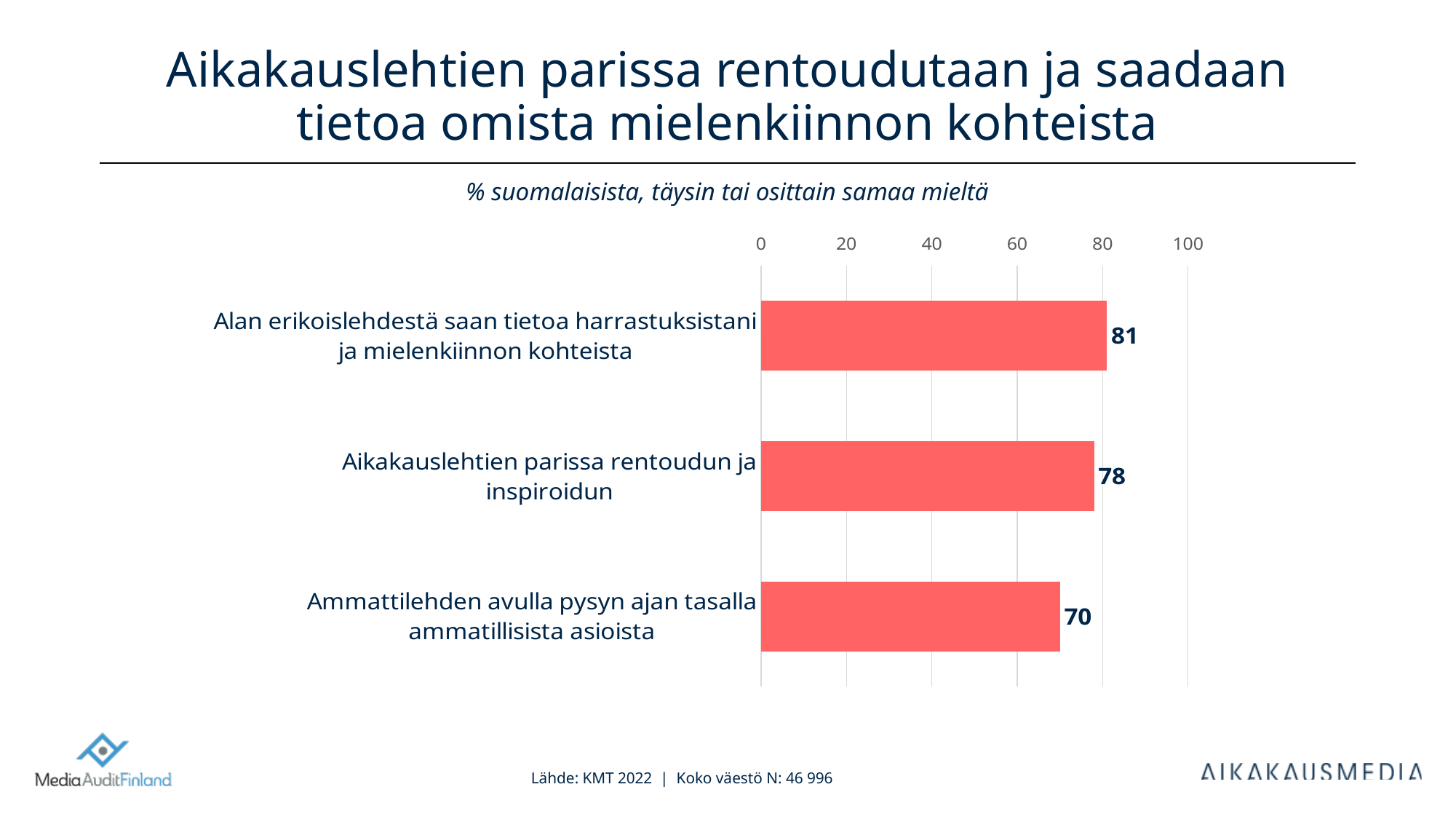
Which is larger: the value for "Aikakauslehtien parissa rentoudun ja inspiroidun" or for "Ammattilehden avulla pysyn ajan tasalla ammatillisista asioista"? Aikakauslehtien parissa rentoudun ja inspiroidun What is the difference between the values for "Alan erikoislehdestä saan tietoa harrastuksistani ja mielenkiinnon kohteista" and "Ammattilehden avulla pysyn ajan tasalla ammatillisista asioista"? 11 Is the value for "Ammattilehden avulla pysyn ajan tasalla ammatillisista asioista" greater or less than 80? less Which statement has the highest value? Alan erikoislehdestä saan tietoa harrastuksistani ja mielenkiinnon kohteista What is the value for "Aikakauslehtien parissa rentoudun ja inspiroidun"? 78 What is the subtitle shown above the chart? % suomalaisista, täysin tai osittain samaa mieltä What is the value for "Alan erikoislehdestä saan tietoa harrastuksistani ja mielenkiinnon kohteista"? 81 What is the value for "Ammattilehden avulla pysyn ajan tasalla ammatillisista asioista"? 70 What is the difference between the values for "Alan erikoislehdestä saan tietoa harrastuksistani ja mielenkiinnon kohteista" and "Aikakauslehtien parissa rentoudun ja inspiroidun"? 3 How many statements are shown in the chart? 3 What kind of chart is shown on the slide? bar chart Which statement has the lowest value? Ammattilehden avulla pysyn ajan tasalla ammatillisista asioista